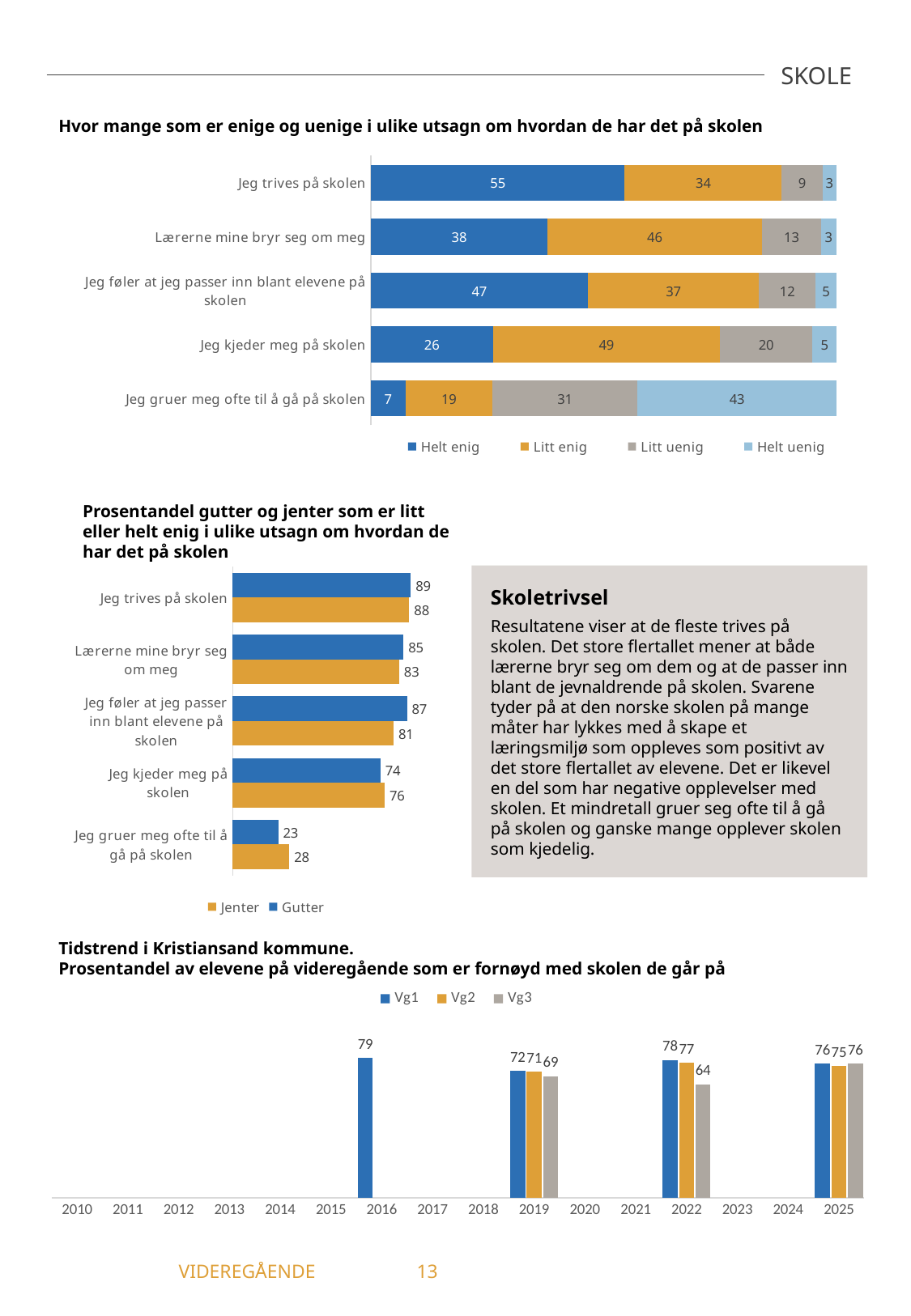
In the chart 'Tidstrend i Kristiansand kommune', what is the Vg3 value for 2022? 64 In the chart 'Prosentandel gutter og jenter som er litt eller helt enig i ulike utsagn om hvordan de har det på skolen', which is larger for 'Jeg gruer meg ofte til å gå på skolen': Jenter or Gutter? Jenter In the chart 'Tidstrend i Kristiansand kommune', which year has the highest Vg1 value? 2016 In the chart 'Hvor mange som er enige og uenige i ulike utsagn om hvordan de har det på skolen', what is the 'Helt uenig' value for 'Jeg gruer meg ofte til å gå på skolen'? 43 In the chart 'Hvor mange som er enige og uenige i ulike utsagn om hvordan de har det på skolen', which statement has the highest 'Helt enig' value? Jeg trives på skolen In the chart 'Hvor mange som er enige og uenige i ulike utsagn om hvordan de har det på skolen', what is the difference between the 'Litt enig' values for 'Jeg kjeder meg på skolen' and 'Jeg trives på skolen'? 15 In the chart 'Hvor mange som er enige og uenige i ulike utsagn om hvordan de har det på skolen', how many series does the legend list? 4 In the chart 'Prosentandel gutter og jenter som er litt eller helt enig i ulike utsagn om hvordan de har det på skolen', what is the value for Gutter on 'Jeg trives på skolen'? 89 In the chart 'Prosentandel gutter og jenter som er litt eller helt enig i ulike utsagn om hvordan de har det på skolen', how many statements are shown? 5 What kind of chart is 'Tidstrend i Kristiansand kommune'? Bar chart In the chart 'Prosentandel gutter og jenter som er litt eller helt enig i ulike utsagn om hvordan de har det på skolen', what is the difference between Gutter and Jenter for 'Jeg føler at jeg passer inn blant elevene på skolen'? 6 In the chart 'Hvor mange som er enige og uenige i ulike utsagn om hvordan de har det på skolen', what is the 'Helt enig' value for 'Jeg trives på skolen'? 55